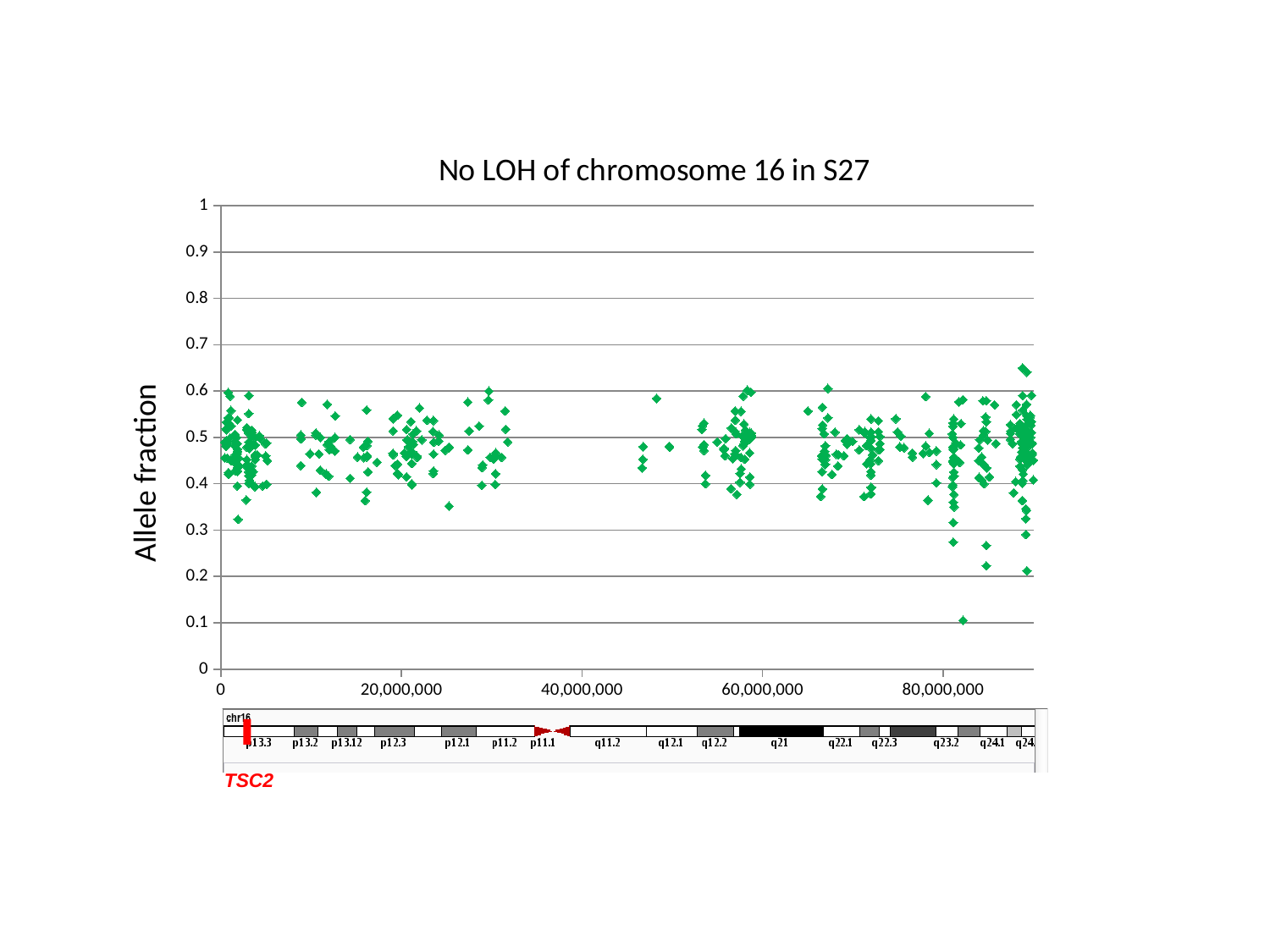
Is the highest plotted point greater or less than 0.6? greater Is the highest plotted point greater or less than 0.7? less What is the title of the chart? No LOH of chromosome 16 in S27 Are the plotted points mostly above or below 0.7 on the y axis? below What kind of chart is shown on the slide? scatter plot What is the label of the y axis? Allele fraction What is the largest labelled tick on the x axis? 80,000,000